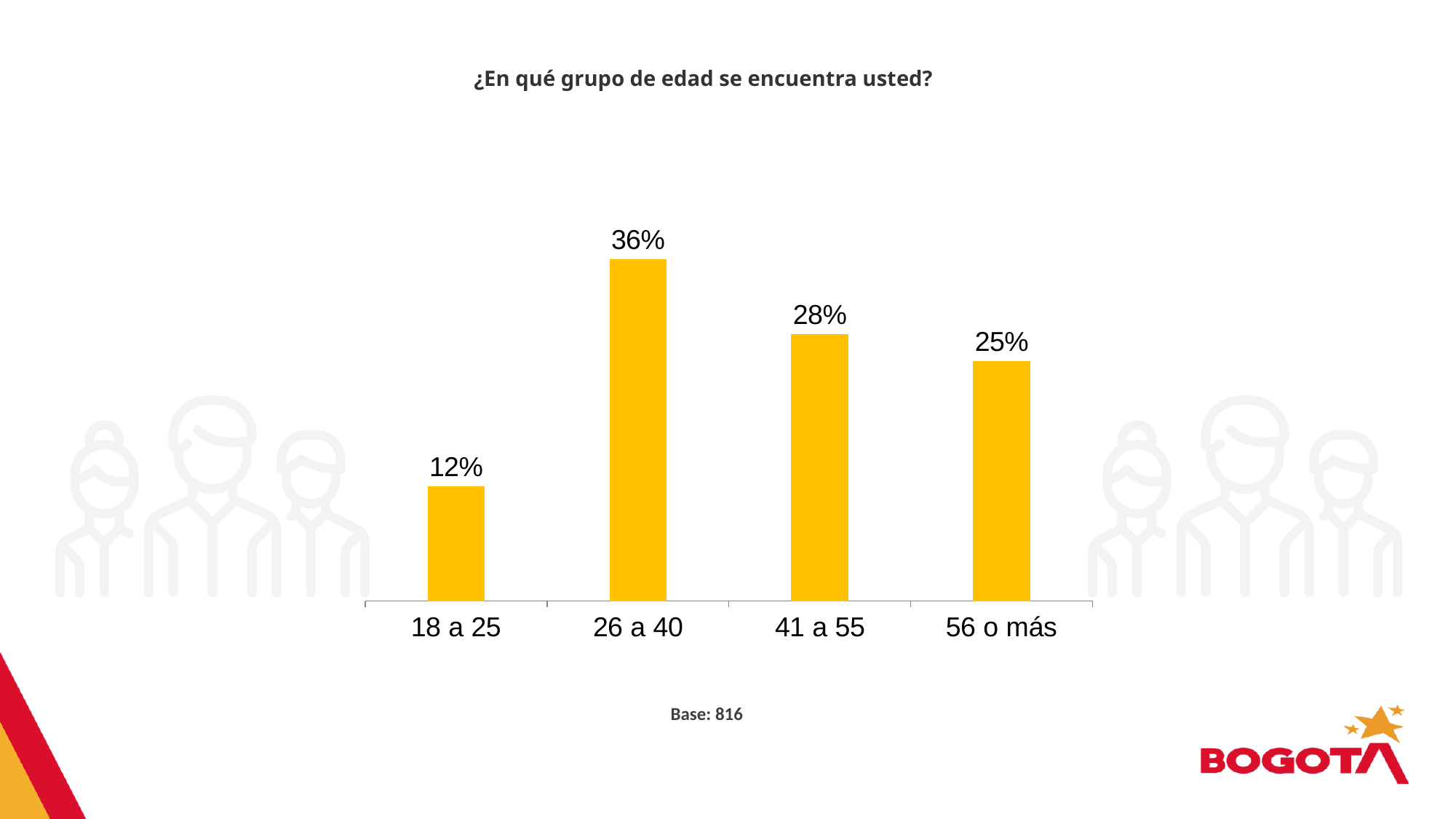
What base (sample size) is stated below the chart? 816 What is the value for the 18 a 25 age group? 12% What kind of chart is shown on the slide? Bar chart What is the value for the 56 o más age group? 25% Which age group has the lowest value? 18 a 25 What is the difference between the values for 26 a 40 and 41 a 55? 8% What is the difference between the values for 56 o más and 18 a 25? 13% Which age group has the highest value? 26 a 40 Which is larger, the value for 41 a 55 or the value for 56 o más? 41 a 55 How many age groups are shown on the chart? 4 What is the value for the 26 a 40 age group? 36% What is the title of the chart? ¿En qué grupo de edad se encuentra usted?